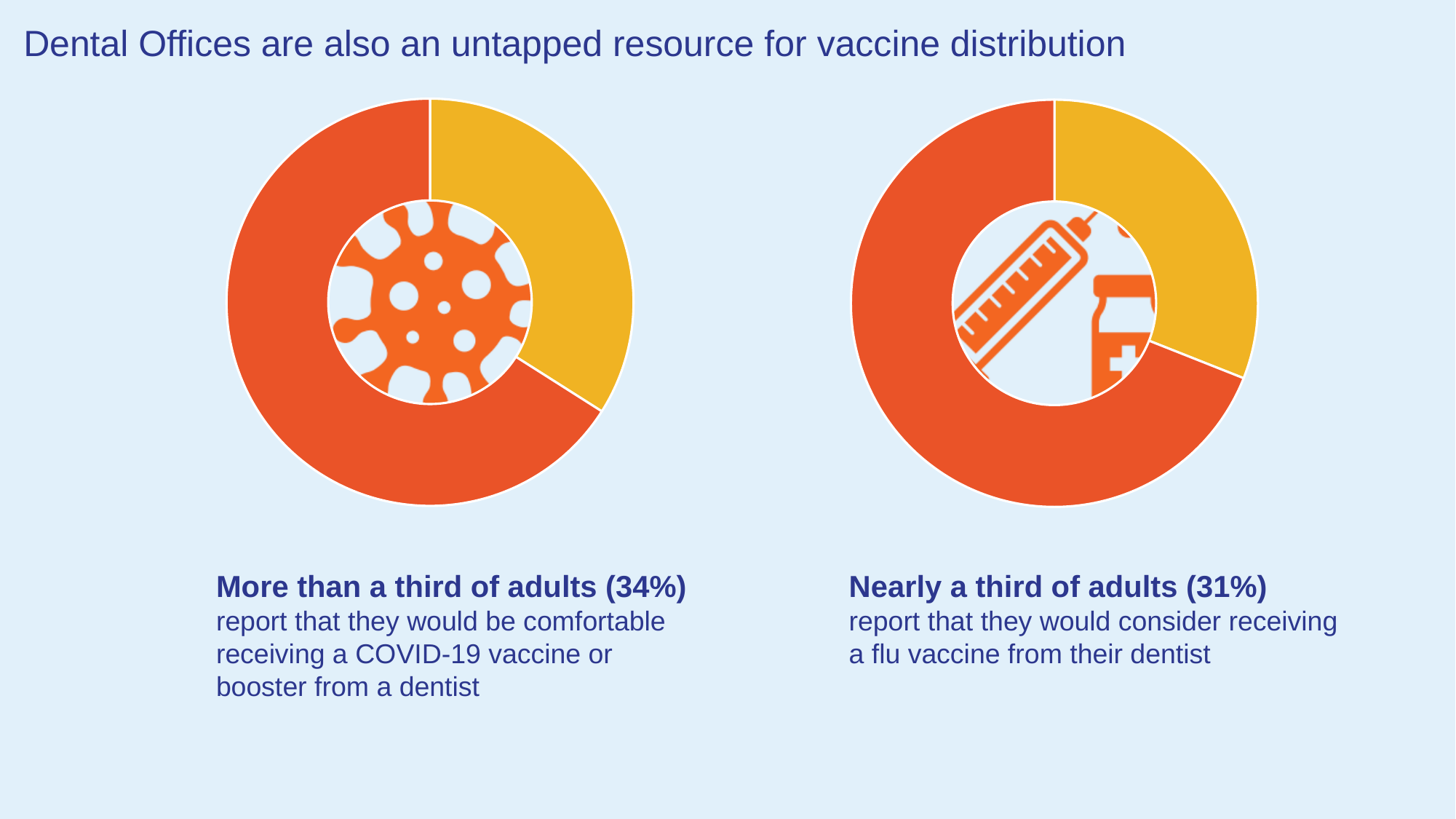
Which is larger: the share of adults comfortable receiving a COVID-19 vaccine from a dentist (left chart) or the share who would consider a flu vaccine from their dentist (right chart)? COVID-19 vaccine (34%) What is the title of the slide containing the two donut charts? Dental Offices are also an untapped resource for vaccine distribution What colour is the slice representing the 31% of adults in the right chart? Yellow How many donut charts are shown on the slide? 2 In the left chart, what share of adults report they would be comfortable receiving a COVID-19 vaccine or booster from a dentist? 34% How many slices does each donut chart on the slide have? 2 In the right chart, what share of adults report they would consider receiving a flu vaccine from their dentist? 31% What is the difference between the 34% in the left chart and the 31% in the right chart? 3 percentage points In the left chart, is the yellow slice larger or smaller than the red slice? Smaller In the right chart, is the red slice greater or less than 50% of the donut? greater What kind of chart is shown on the left side of the slide? Donut (pie) chart